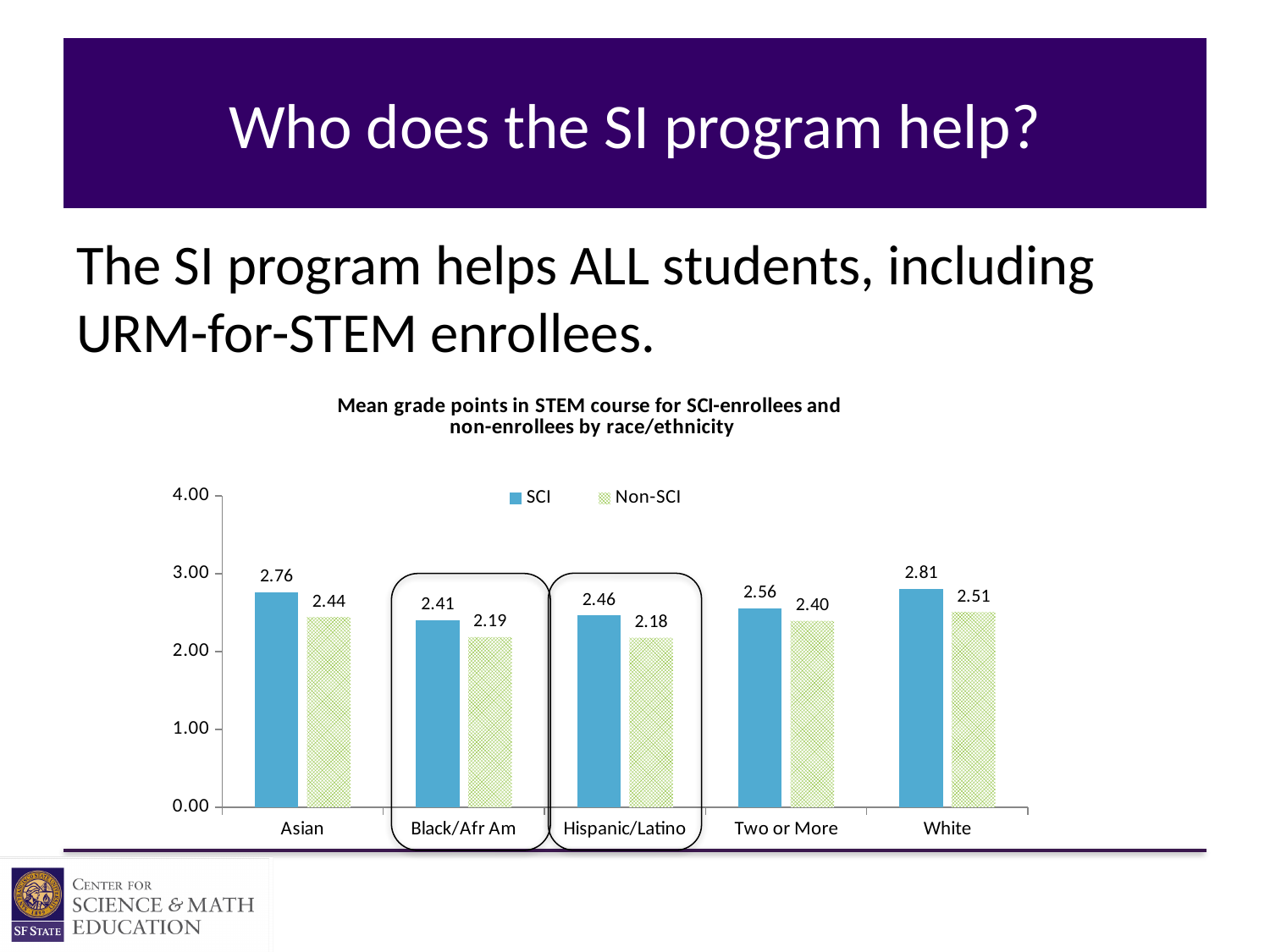
What is the Non-SCI mean grade point for Hispanic/Latino students? 2.18 Is the Non-SCI value for Asian students greater or less than 3.00? less Which is larger for White students, the SCI value or the Non-SCI value? SCI What is the title of the chart? Mean grade points in STEM course for SCI-enrollees and non-enrollees by race/ethnicity What is the SCI mean grade point for Asian students? 2.76 Which race/ethnicity category has the lowest Non-SCI mean grade point? Hispanic/Latino What is the SCI value for Two or More? 2.56 How many series does the legend list? 2 What kind of chart is shown on the slide? bar chart How many race/ethnicity categories are shown on the x axis? 5 Which race/ethnicity category has the highest SCI mean grade point? White What is the difference between the SCI and Non-SCI values for Black/Afr Am? 0.22